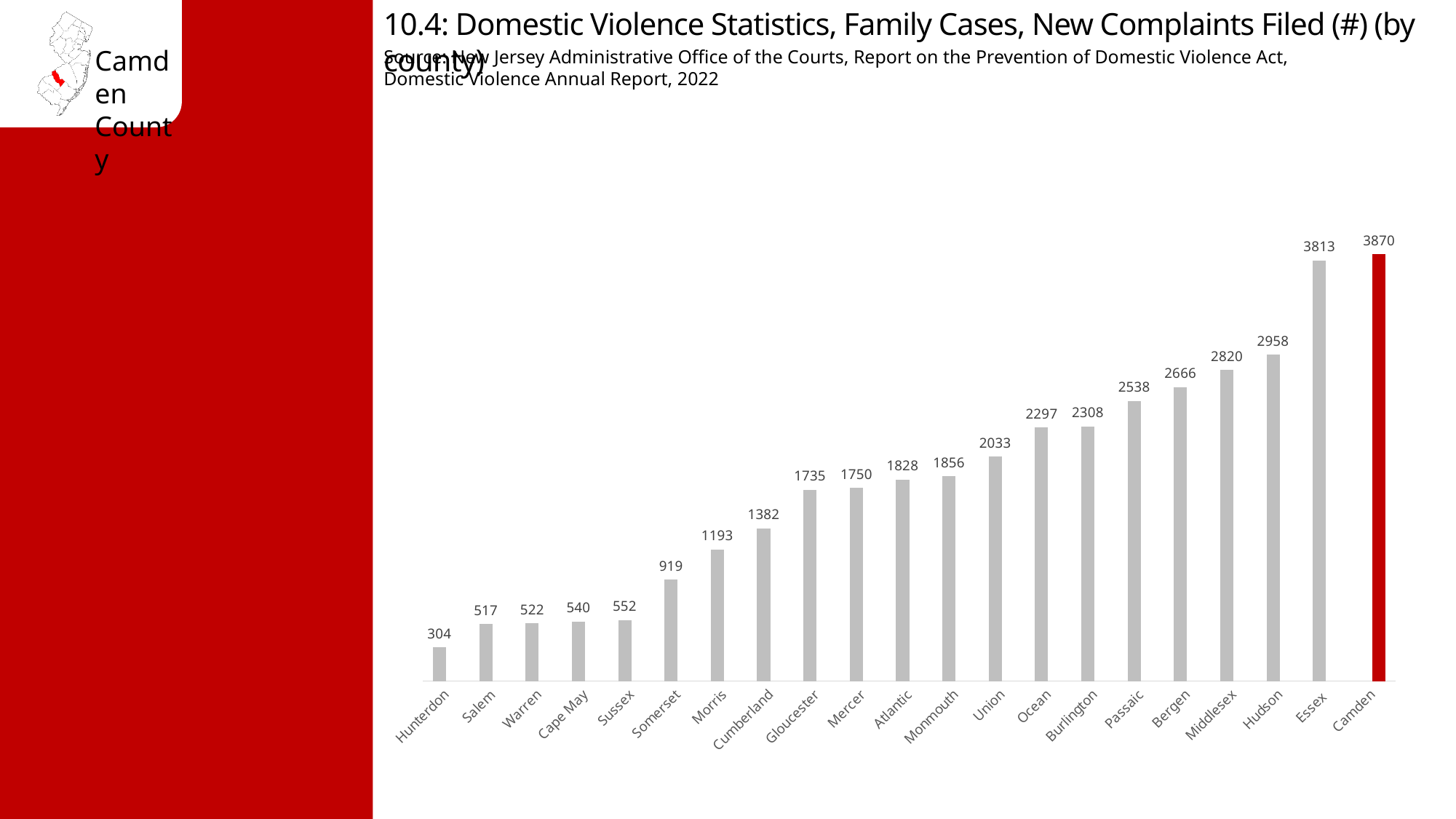
What is the value shown for Burlington? 2308 What is the difference between the values for Camden and Essex? 57 What is the value shown for Gloucester? 1735 Which county has the lowest number of new complaints filed? Hunterdon What is the difference between the values for Hudson and Middlesex? 138 Which county has the highest number of new complaints filed? Camden Which has a larger value, Somerset or Morris? Morris Which bar is highlighted in red on the chart? Camden What kind of chart is shown on the slide? Bar chart How many counties are shown on the chart? 21 What is the number of new domestic violence complaints filed for Camden? 3870 What is the value shown for Hunterdon? 304